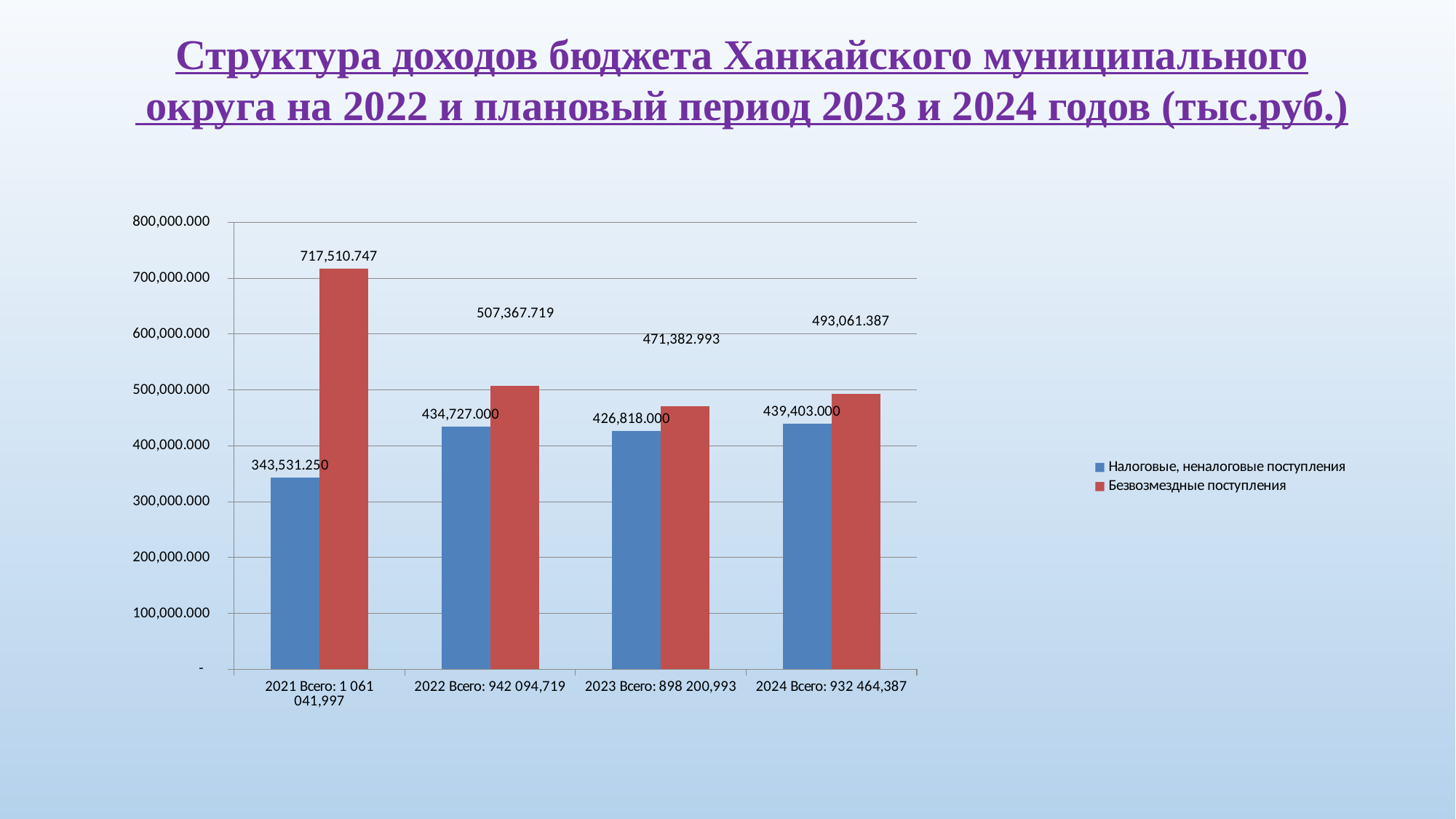
How many years (categories) are shown on the x axis? 4 What is the difference between Безвозмездные поступления and Налоговые, неналоговые поступления in 2021? 373,979.497 What is the difference between Налоговые, неналоговые поступления in 2022 and in 2023? 7,909.000 Is the value of Безвозмездные поступления for 2023 greater or less than 500,000.000? less Which is larger in 2023: Налоговые, неналоговые поступления or Безвозмездные поступления? Безвозмездные поступления What is the value of Налоговые, неналоговые поступления for 2021? 343,531.250 In which year is Налоговые, неналоговые поступления lowest? 2021 In which year is Безвозмездные поступления highest? 2021 What kind of chart is shown on the slide? bar chart How many series does the legend list? 2 What is the value of Безвозмездные поступления for 2024? 493,061.387 What is the value of Безвозмездные поступления for 2022? 507,367.719